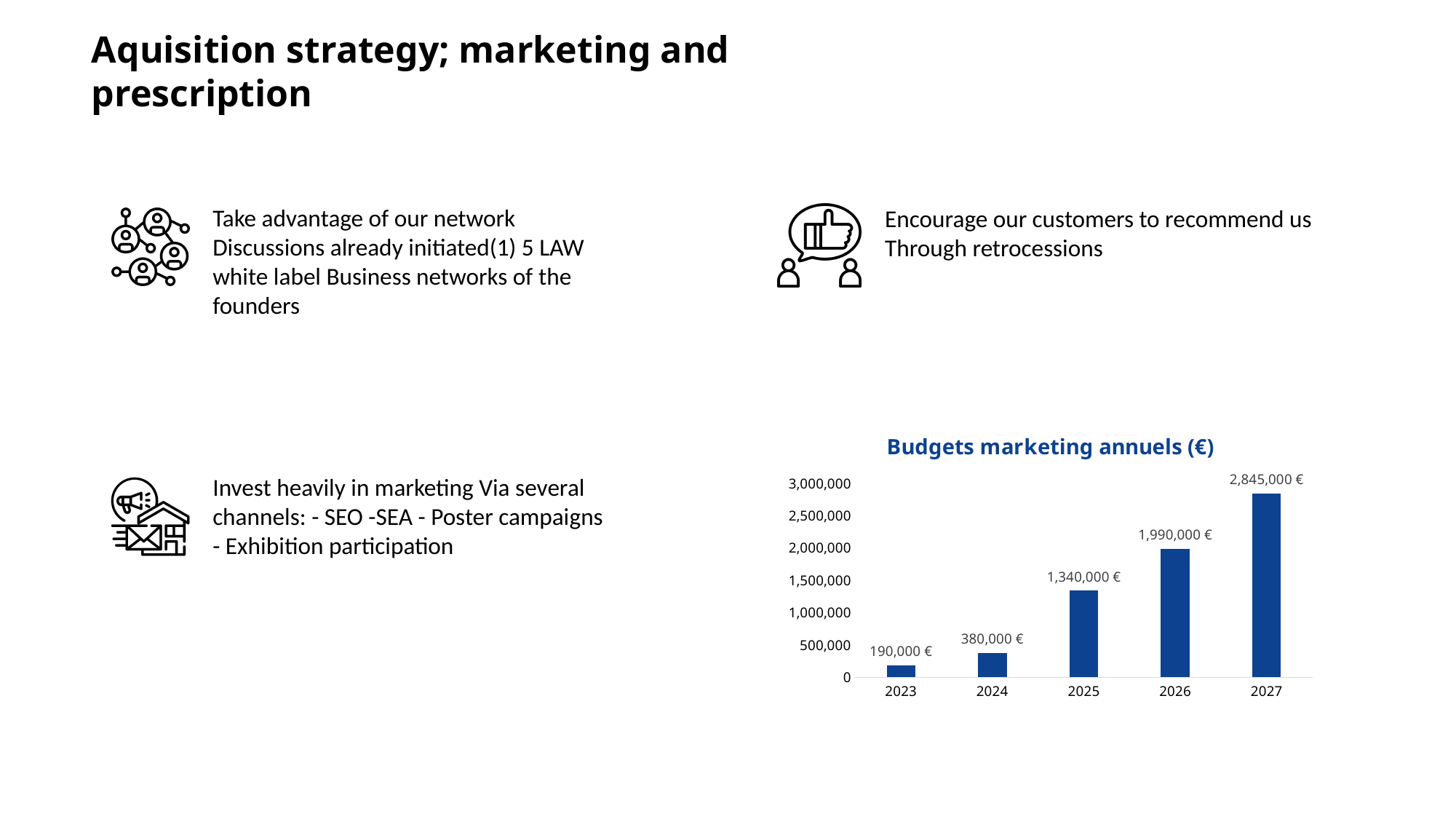
What is the difference between the 2024 and 2023 marketing budgets? 190,000 € How many years are shown on the chart? 5 What is the marketing budget for 2023? 190,000 € Is the marketing budget for 2026 greater or less than 1,500,000? greater Which year has the highest marketing budget? 2027 Which year has a larger marketing budget, 2024 or 2026? 2026 What kind of chart is used to show the annual marketing budgets? Bar chart Do the marketing budgets rise or fall from 2023 to 2027? Rise What is the marketing budget for 2025? 1,340,000 € What is the marketing budget for 2027? 2,845,000 € Which year has the lowest marketing budget? 2023 What is the difference between the 2026 and 2025 marketing budgets? 650,000 €